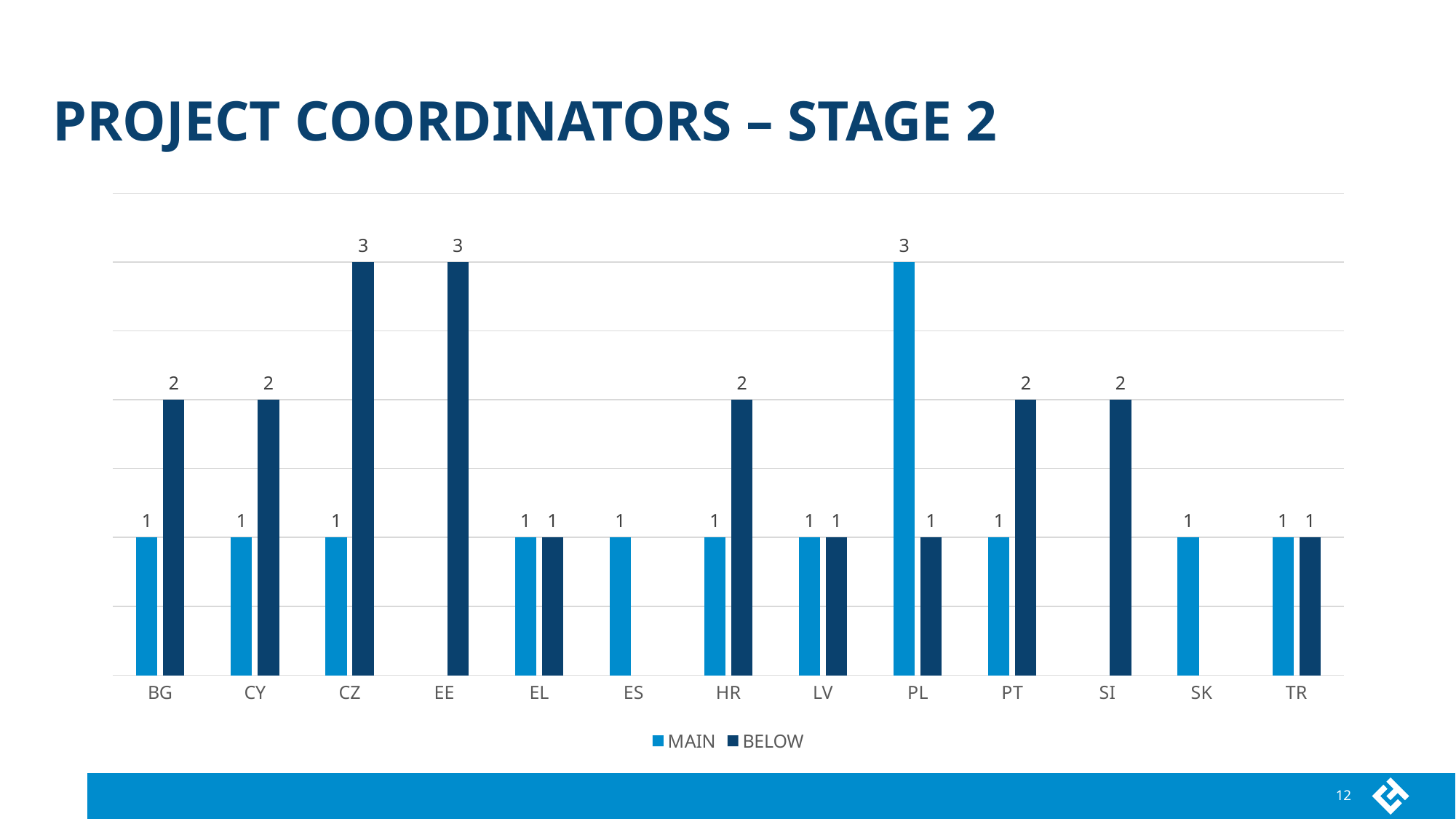
How many series does the legend list? 2 What is the difference between the BELOW value and the MAIN value for BG? 1 What is the title of the chart? PROJECT COORDINATORS – STAGE 2 Which category has the highest MAIN value? PL What is the difference between the MAIN value for PL and the BELOW value for PL? 2 Which series is shown in the darker blue colour? BELOW What is the BELOW value for SI? 2 How many categories are shown on the x axis? 13 What is the BELOW value for CZ? 3 What is the MAIN value for PL? 3 What type of chart is shown on the slide? bar chart Which is larger for HR, the MAIN value or the BELOW value? BELOW